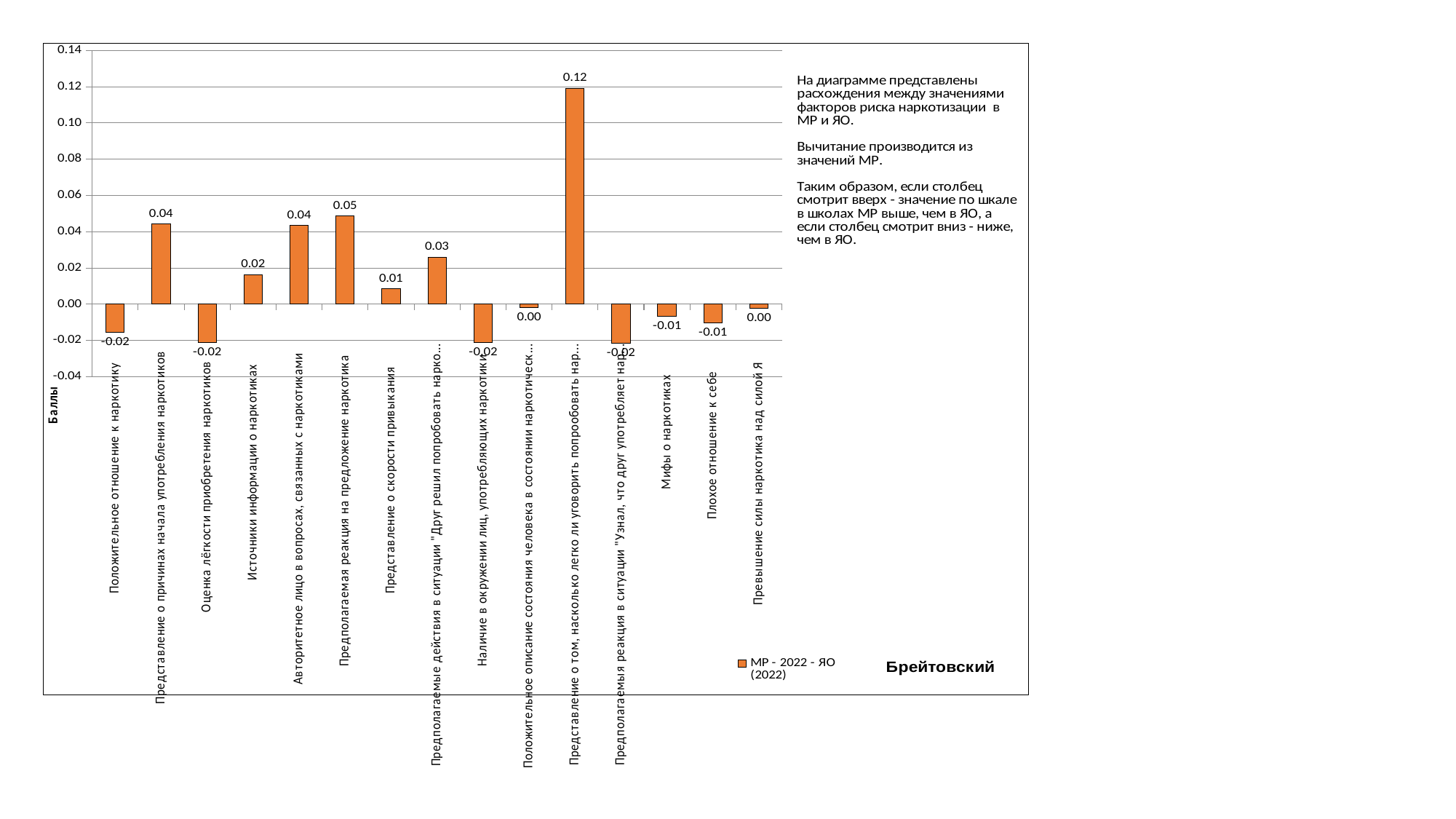
How many categories are shown on the x axis? 15 What kind of chart is shown? Bar chart What is the difference between the values for "Предполагаемая реакция на предложение наркотика" and "Представление о скорости привыкания"? 0.04 Which category has the highest value? Представление о том, насколько легко ли уговорить попробовать нар... How many series does the legend list? 1 What is the value for "Мифы о наркотиках"? -0.01 What is the value for "Источники информации о наркотиках"? 0.02 What is the value for "Представление о скорости привыкания"? 0.01 What is the value for "Превышение силы наркотика над силой Я"? 0.00 What is the title of the vertical axis? Баллы What is the value for "Предполагаемая реакция на предложение наркотика"? 0.05 Which is larger: the value for "Источники информации о наркотиках" or for "Плохое отношение к себе"? Источники информации о наркотиках